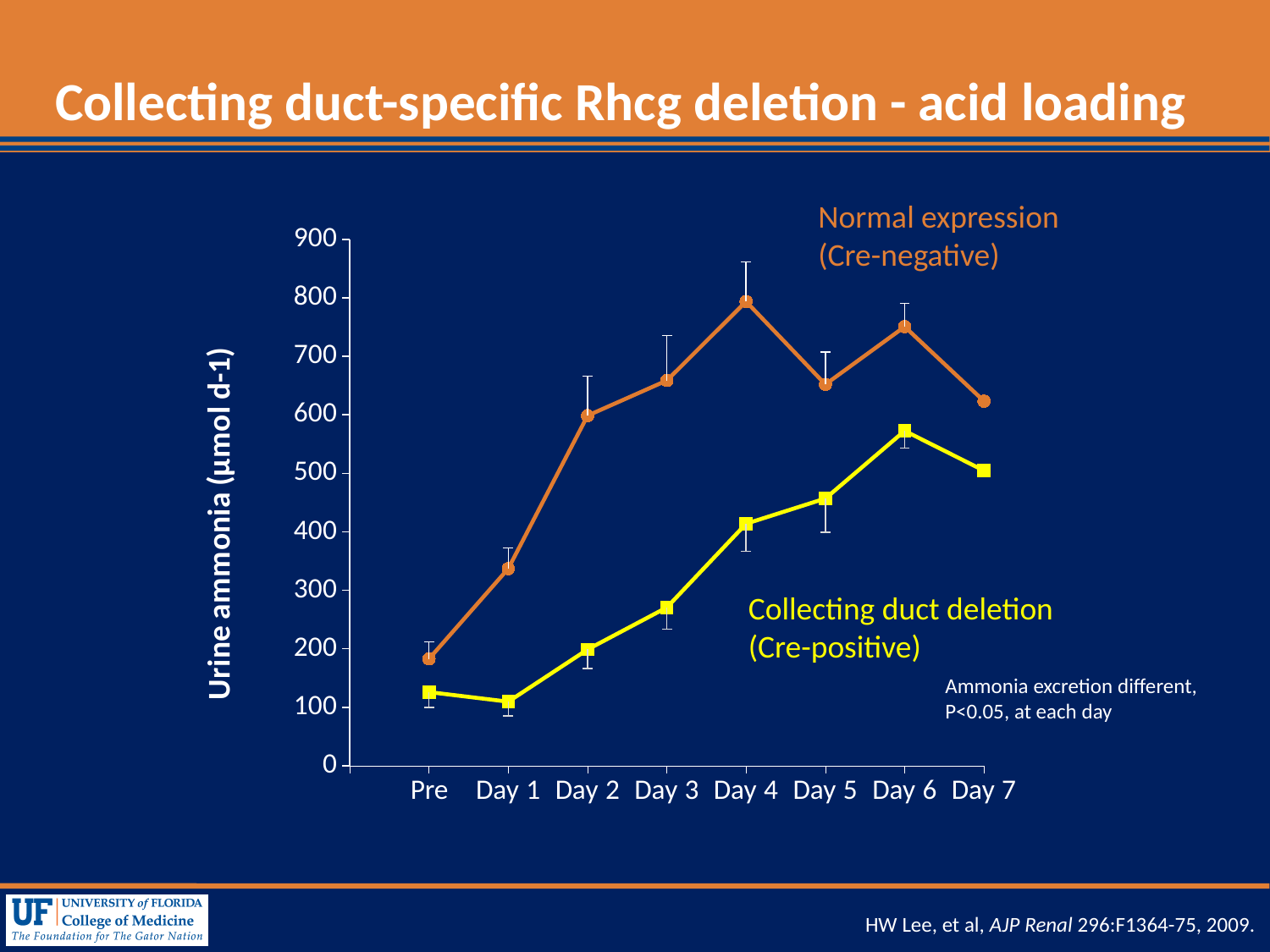
Is the Normal expression (Cre-negative) value at Day 4 greater or less than 700? greater At Day 4, which series has the larger urine ammonia value, Normal expression (Cre-negative) or Collecting duct deletion (Cre-positive)? Normal expression (Cre-negative) Is the Collecting duct deletion (Cre-positive) value at Day 3 greater or less than 300? less Does the Collecting duct deletion (Cre-positive) series rise or fall from Day 1 to Day 6? rise What is the label of the y axis? Urine ammonia (µmol d-1) At which time point is the Normal expression (Cre-negative) series lowest? Pre Is the Collecting duct deletion (Cre-positive) value at Pre greater or less than 200? less At which time point does the Normal expression (Cre-negative) series reach its highest value? Day 4 At which time point does the Collecting duct deletion (Cre-positive) series reach its highest value? Day 6 How many data series are plotted on the chart? 2 How many time points are plotted along the x axis? 8 What kind of chart is shown on the slide? line chart